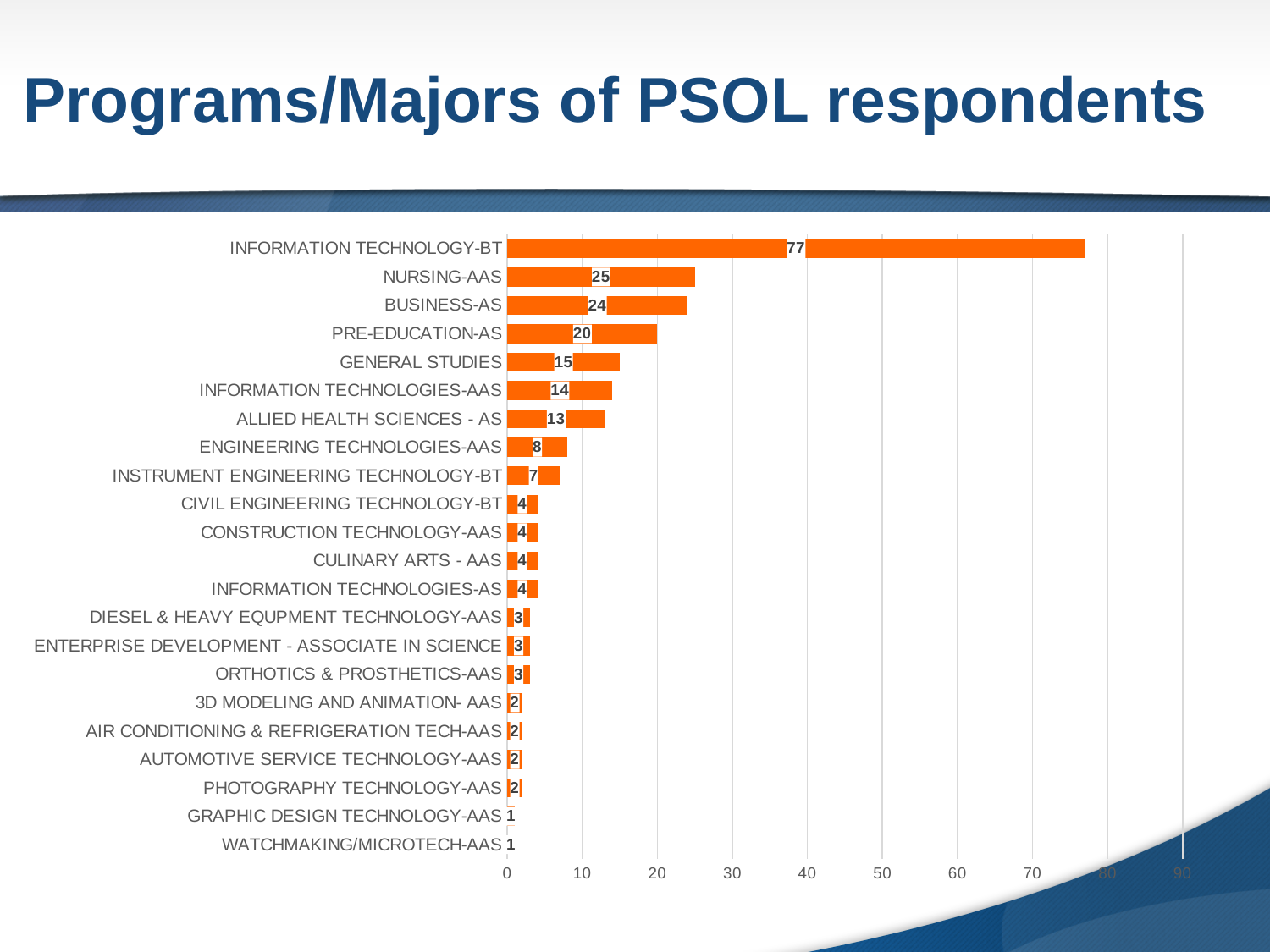
Which has a larger value, ENGINEERING TECHNOLOGIES-AAS or INSTRUMENT ENGINEERING TECHNOLOGY-BT? ENGINEERING TECHNOLOGIES-AAS How many programs/majors are listed in the chart? 22 What is the difference between the values for INFORMATION TECHNOLOGY-BT and NURSING-AAS? 52 What is the value for GENERAL STUDIES? 15 What is the value for ALLIED HEALTH SCIENCES - AS? 13 What type of chart is shown on the slide? bar chart What is the difference between the values for BUSINESS-AS and PRE-EDUCATION-AS? 4 How many respondents are in INFORMATION TECHNOLOGY-BT? 77 What is the value for NURSING-AAS? 25 Which program has the highest number of respondents? INFORMATION TECHNOLOGY-BT Is the value for INFORMATION TECHNOLOGY-BT greater or less than 70? greater What is the title of the slide's chart? Programs/Majors of PSOL respondents